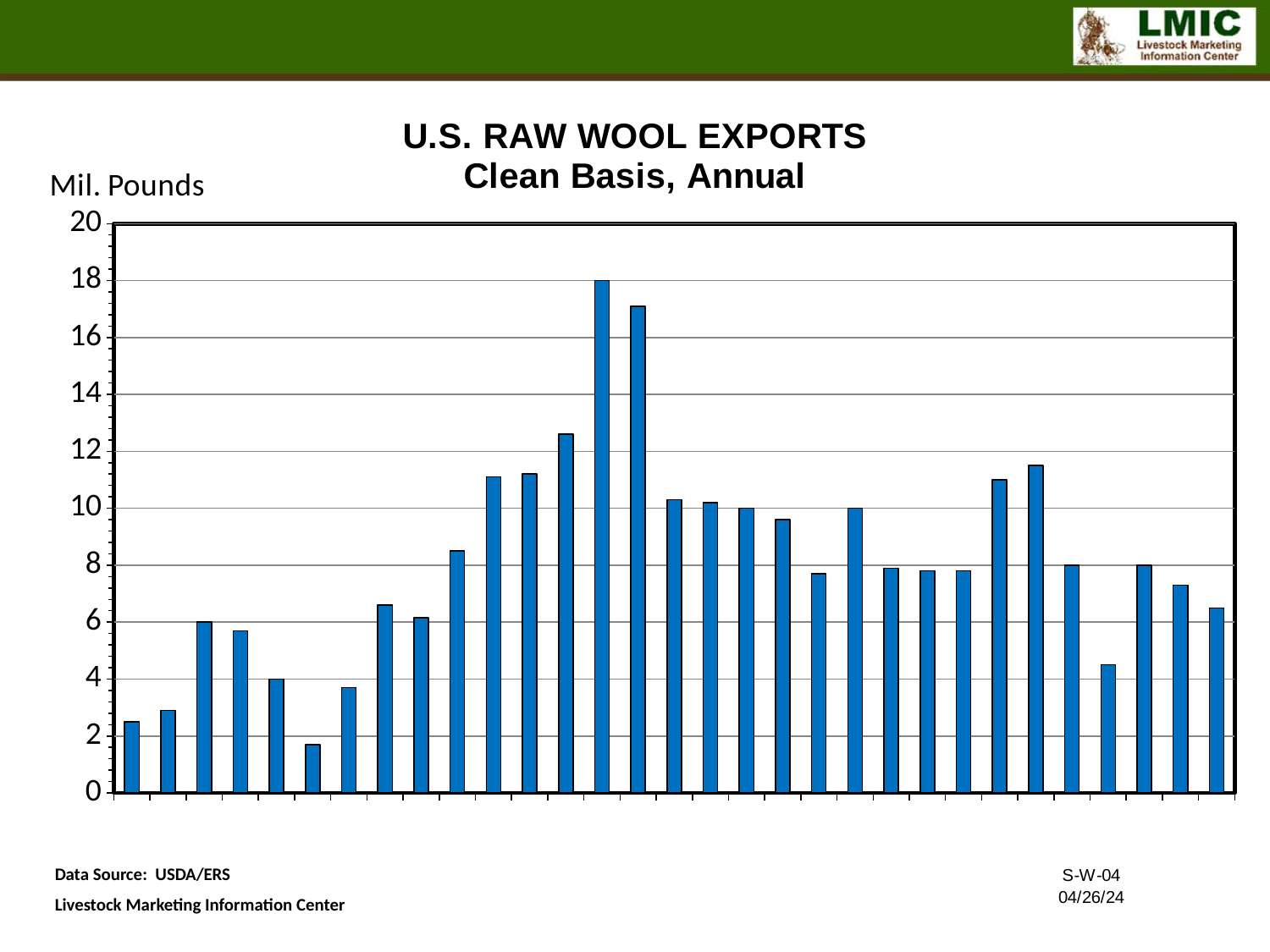
Is the value of the tallest bar greater or less than 16? greater What is the title of the chart? U.S. RAW WOOL EXPORTS Clean Basis, Annual How many bars exceed 16 million pounds? 2 What unit is shown on the y axis of the chart? Mil. Pounds Is the value of the last (rightmost) bar greater or less than 6? greater What is the highest value shown on the y axis? 20 Is the value of the first (leftmost) bar greater or less than 4? less Which is larger, the first bar or the last bar? the last bar What kind of chart is shown on the slide? bar chart How many bars are plotted in the chart? 31